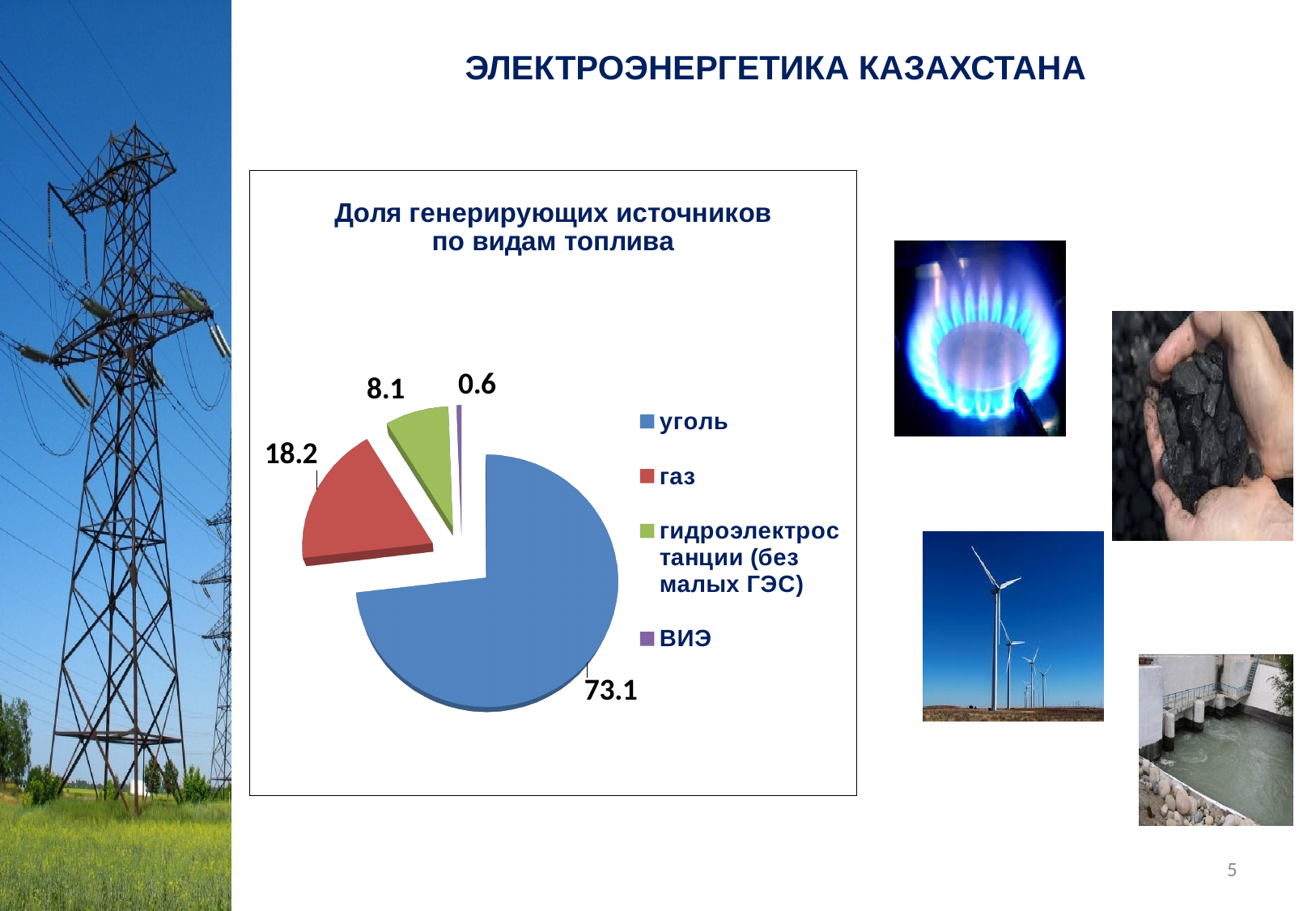
Which is larger, the value for газ or the value for гидроэлектростанции (без малых ГЭС)? газ Which category has the largest slice in the pie chart? уголь What is the difference between the values for газ and гидроэлектростанции (без малых ГЭС)? 10.1 What is the value shown for газ in the pie chart? 18.2 What is the value shown for уголь in the pie chart? 73.1 Which category has the smallest slice in the pie chart? ВИЭ What is the difference between the values for уголь and газ? 54.9 What type of chart is shown on the slide? pie chart How many slices does the pie chart have? 4 What is the value shown for ВИЭ in the pie chart? 0.6 What is the title of the chart? Доля генерирующих источников по видам топлива What is the value shown for гидроэлектростанции (без малых ГЭС) in the pie chart? 8.1